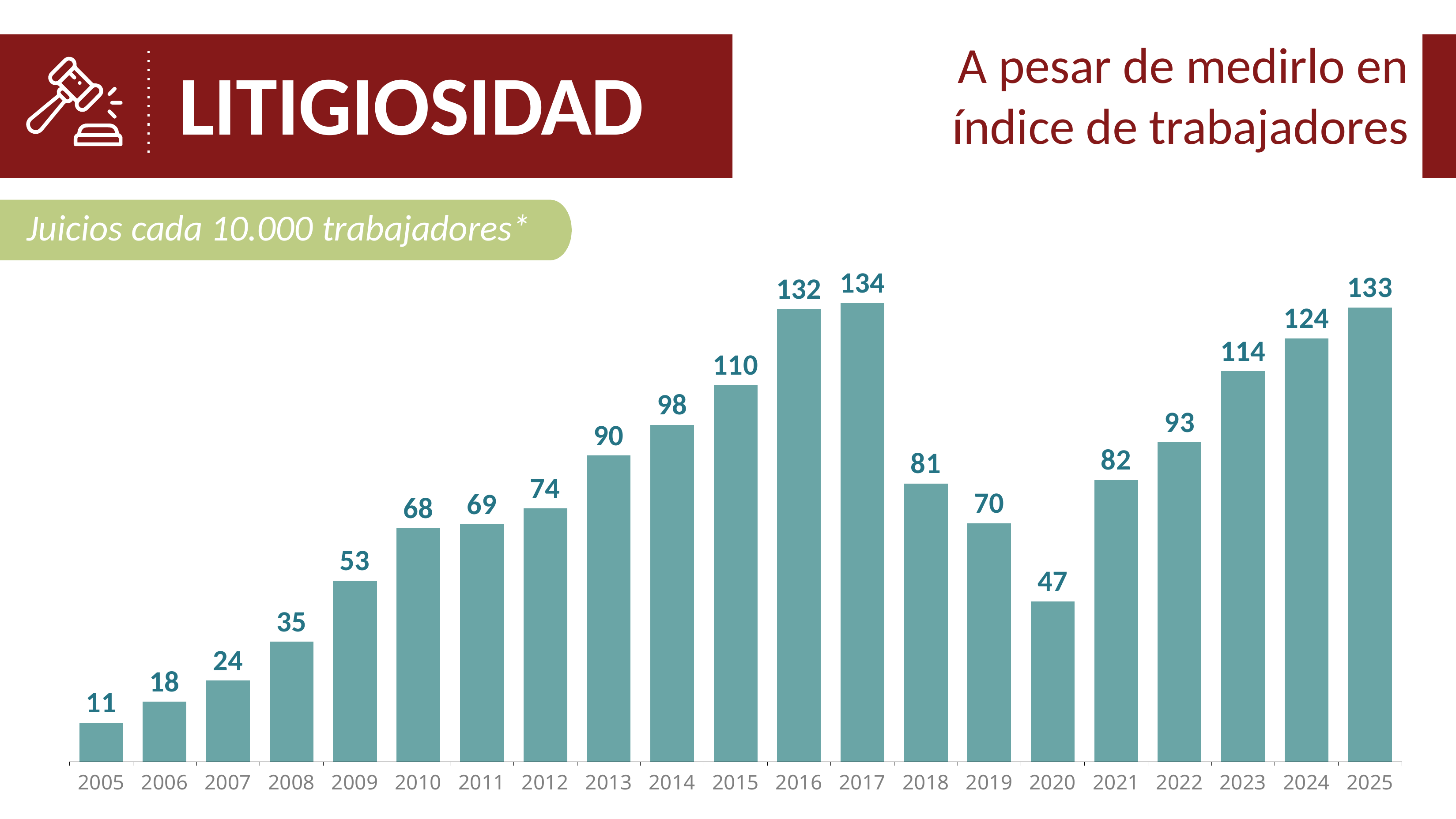
Do the values rise or fall from 2005 to 2017? Rise How many years are shown on the x axis? 21 What does the green label above the chart say the values represent? Juicios cada 10.000 trabajadores* Which year has the highest value? 2017 What is the value for 2020? 47 What is the difference between the values for 2025 and 2024? 9 What kind of chart is shown on the slide? Bar chart Which is larger, the value for 2013 or the value for 2022? 2022 What is the difference between the values for 2017 and 2018? 53 Which year has the lowest value? 2005 What is the value for 2005? 11 What is the value for 2016? 132